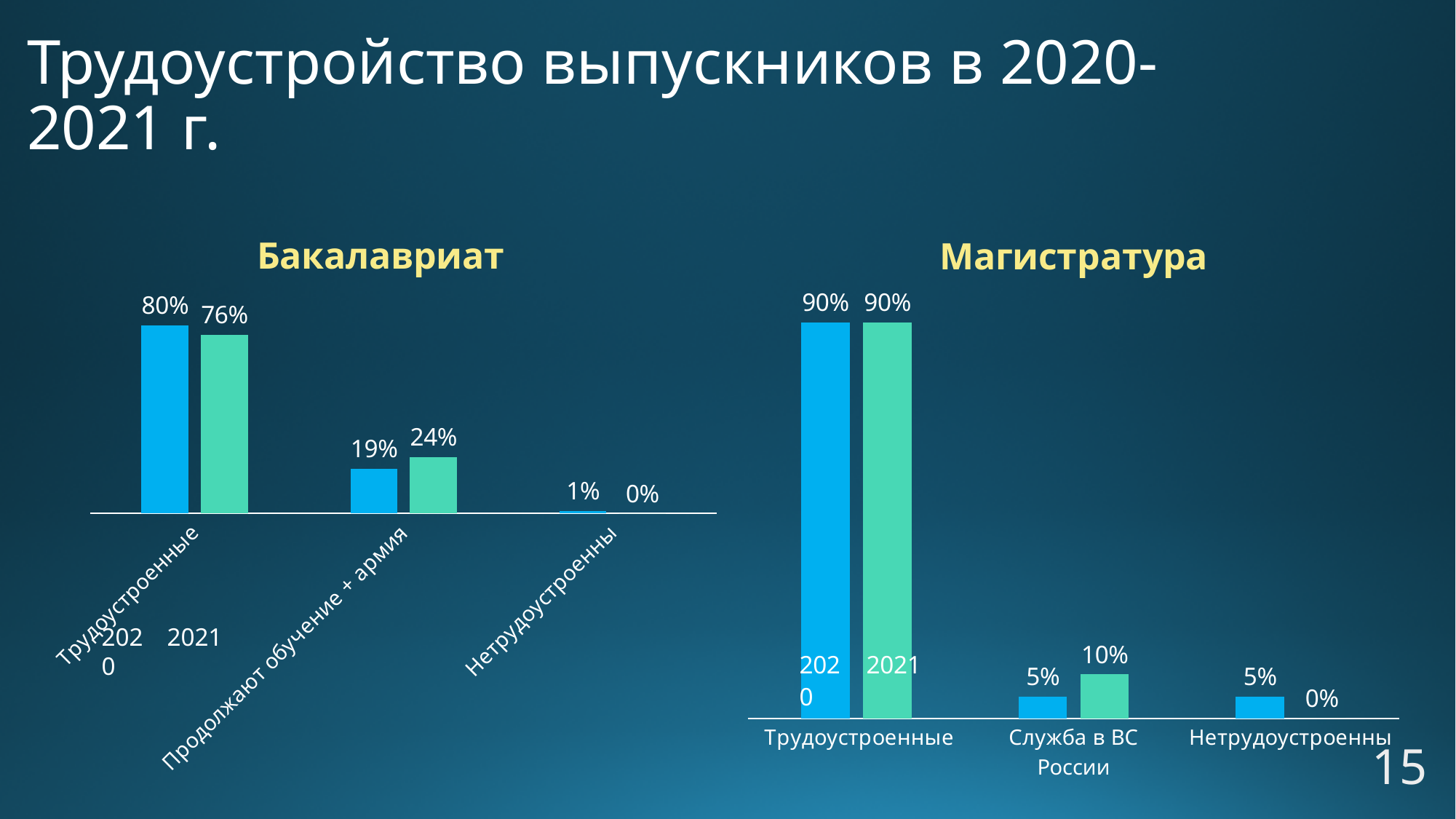
In the "Бакалавриат" chart, what is the value for "Трудоустроенные" in 2020? 80% In the "Магистратура" chart, what is the difference between the 2021 and 2020 values for "Служба в ВС России"? 5% In the "Магистратура" chart, what is the value for "Нетрудоустроенны" in 2020? 5% In the "Магистратура" chart, which is larger for "Служба в ВС России": the 2020 value or the 2021 value? 2021 In the "Бакалавриат" chart, what is the value for "Нетрудоустроенны" in 2020? 1% In the "Бакалавриат" chart, what is the value for "Продолжают обучение + армия" in 2021? 24% In the "Магистратура" chart, what is the value for "Служба в ВС России" in 2021? 10% In the "Бакалавриат" chart, which category has the highest value in 2021? Трудоустроенные What kind of chart is the "Бакалавриат" chart? Bar chart How many categories are shown on the x axis of the "Магистратура" chart? 3 In the "Бакалавриат" chart, what is the difference between the 2020 and 2021 values for "Трудоустроенные"? 4% In the "Магистратура" chart, what is the value for "Трудоустроенные" in 2020? 90%